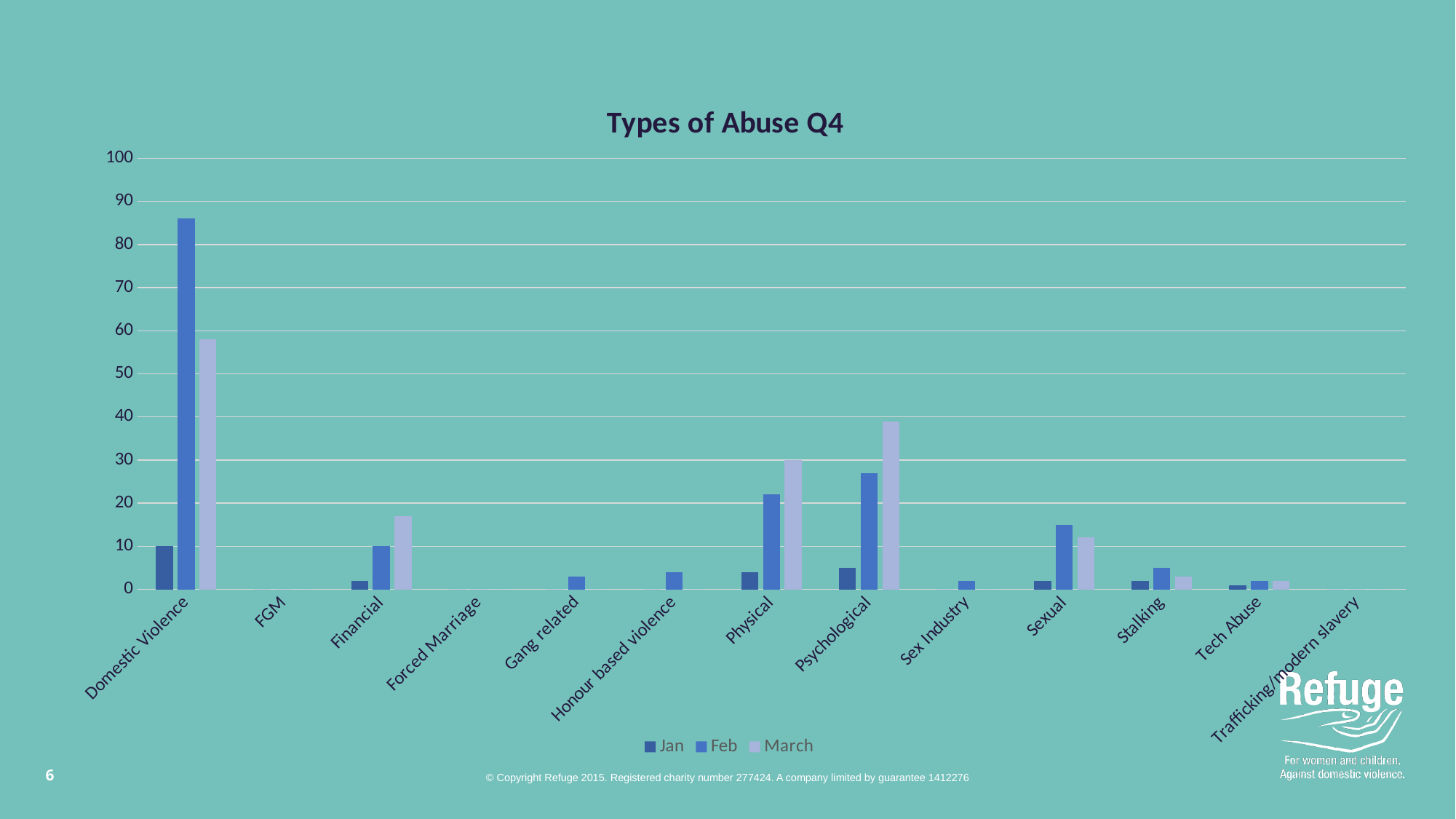
Which category has the highest bar in the chart? Domestic Violence Which is larger for Psychological: the Feb value or the March value? March Is the Feb value for Physical greater or less than 20? greater What type of chart is shown on the slide? bar chart Which is larger for Sexual: the Feb value or the March value? Feb How many series does the legend list? 3 Which month has the highest value for Domestic Violence? Feb Is the Feb value for Domestic Violence greater or less than 80? greater What is the title of the chart? Types of Abuse Q4 How many categories are shown on the x axis? 13 Is the March value for Domestic Violence greater or less than 50? greater